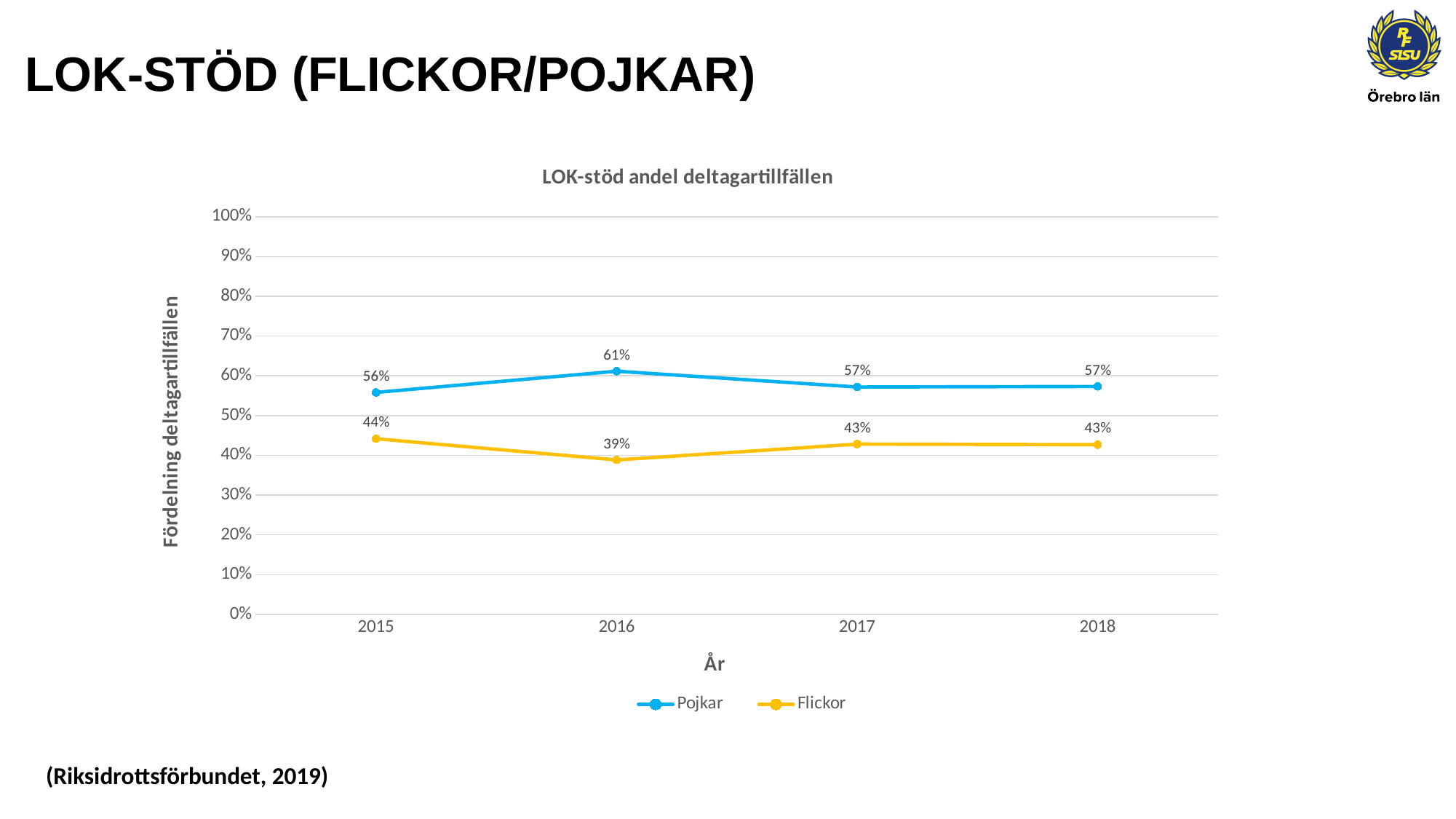
In which year is the Pojkar value highest? 2016 What is the value for Flickor in 2015? 44% Is the value for Flickor in 2016 greater or less than 40%? less What is the difference between the Pojkar and Flickor values in 2016? 22% In which year is the Flickor value lowest? 2016 What is the value for Flickor in 2018? 43% How many years are shown on the x axis? 4 What kind of chart is shown? line chart Which series has the larger value in 2017, Pojkar or Flickor? Pojkar What is the value for Pojkar in 2016? 61% How many series does the legend list? 2 What is the title of the chart? LOK-stöd andel deltagartillfällen